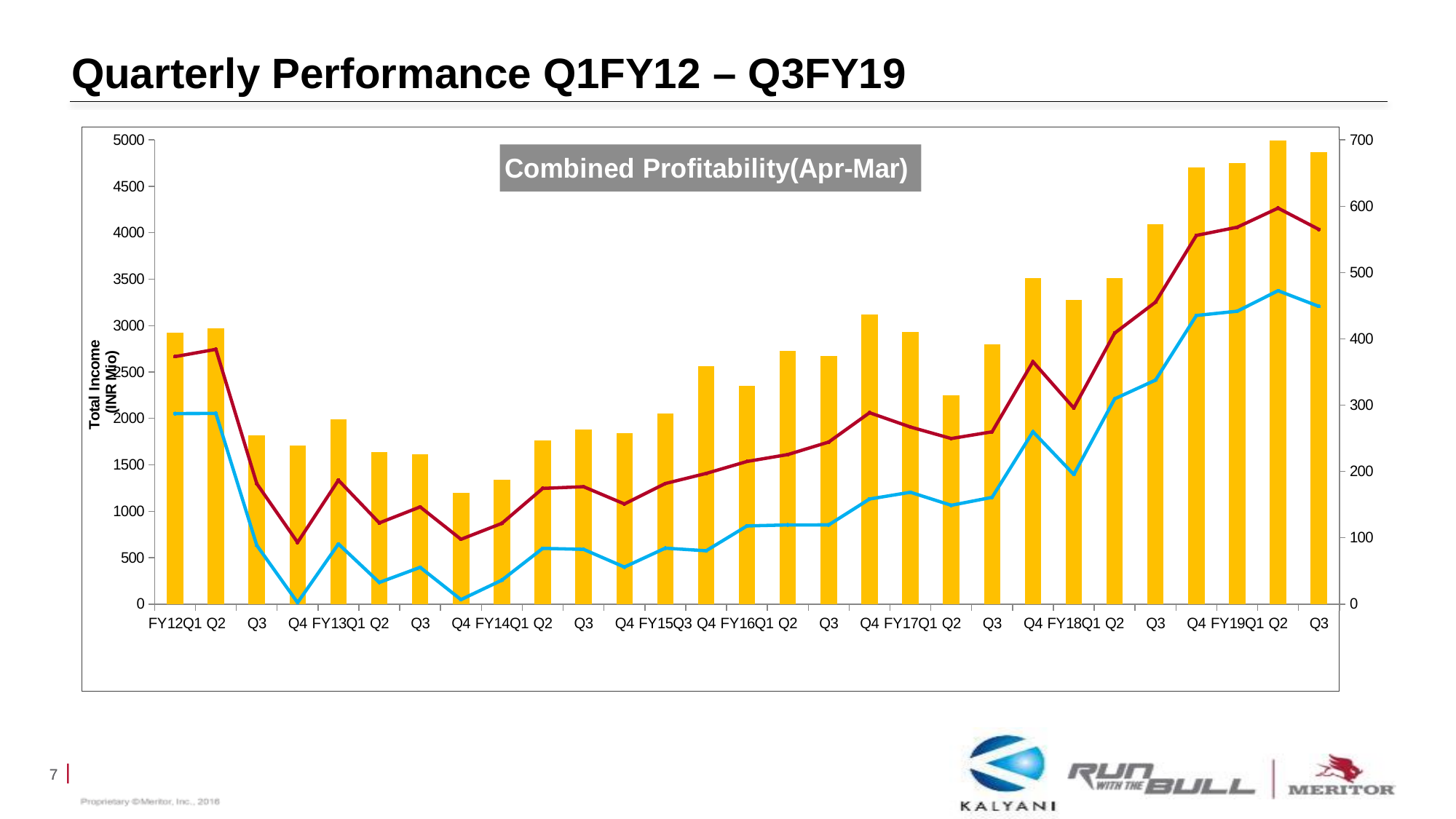
Is the bar value for FY18 Q1 greater or less than 3000? greater Which quarter has the tallest bar? FY19 Q2 What is the label of the left vertical axis? Total Income (INR Mio) Which bar is taller, FY19Q1 or FY17Q1? FY19Q1 How many quarters are plotted on the x axis? 29 Do the bars generally rise or fall from FY14 Q4 to FY19 Q2? rise What kind of chart is shown on the slide? Combined bar and line chart Is the bar value for FY12Q1 greater or less than 2500? greater Is the bar value for FY14 Q4 greater or less than 1500? greater What is the title shown on the chart? Combined Profitability(Apr-Mar) Which quarter has the shortest bar? FY13 Q4